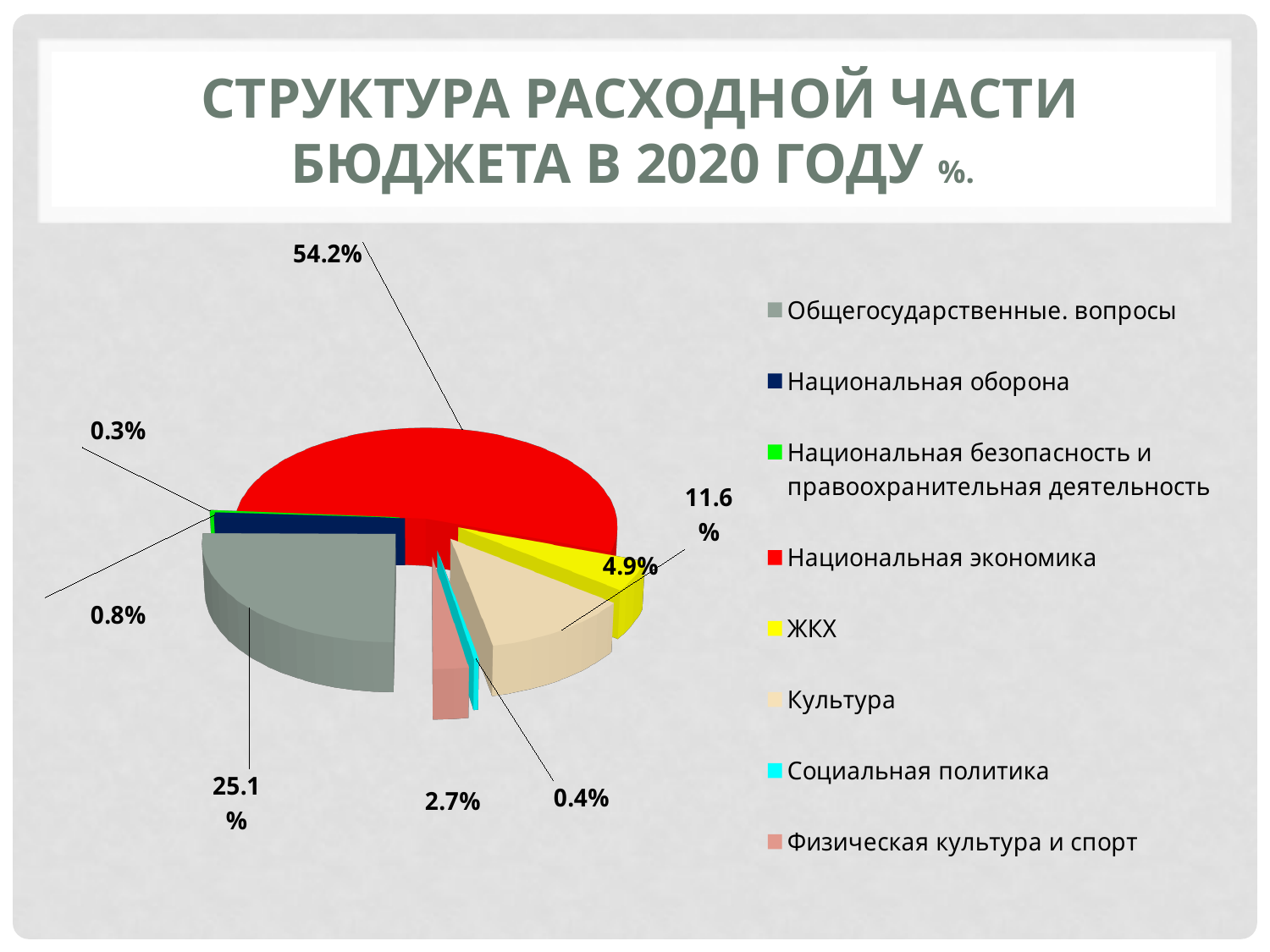
What share of the budget expenditure goes to ЖКХ? 4.9% What share of the budget expenditure goes to Культура? 11.6% What share of the budget expenditure goes to Общегосударственные вопросы? 25.1% Which category has the largest share of the budget expenditure? Национальная экономика How many categories does the legend list? 8 What share of the budget expenditure goes to Физическая культура и спорт? 2.7% Which has a larger share, Культура or ЖКХ? Культура What share of the budget expenditure goes to Социальная политика? 0.4% What share of the budget expenditure goes to Национальная экономика? 54.2% What kind of chart is shown on the slide? pie chart What is the difference between the shares of Национальная экономика and Общегосударственные вопросы? 29.1% Which category has the smallest share of the budget expenditure? Национальная безопасность и правоохранительная деятельность